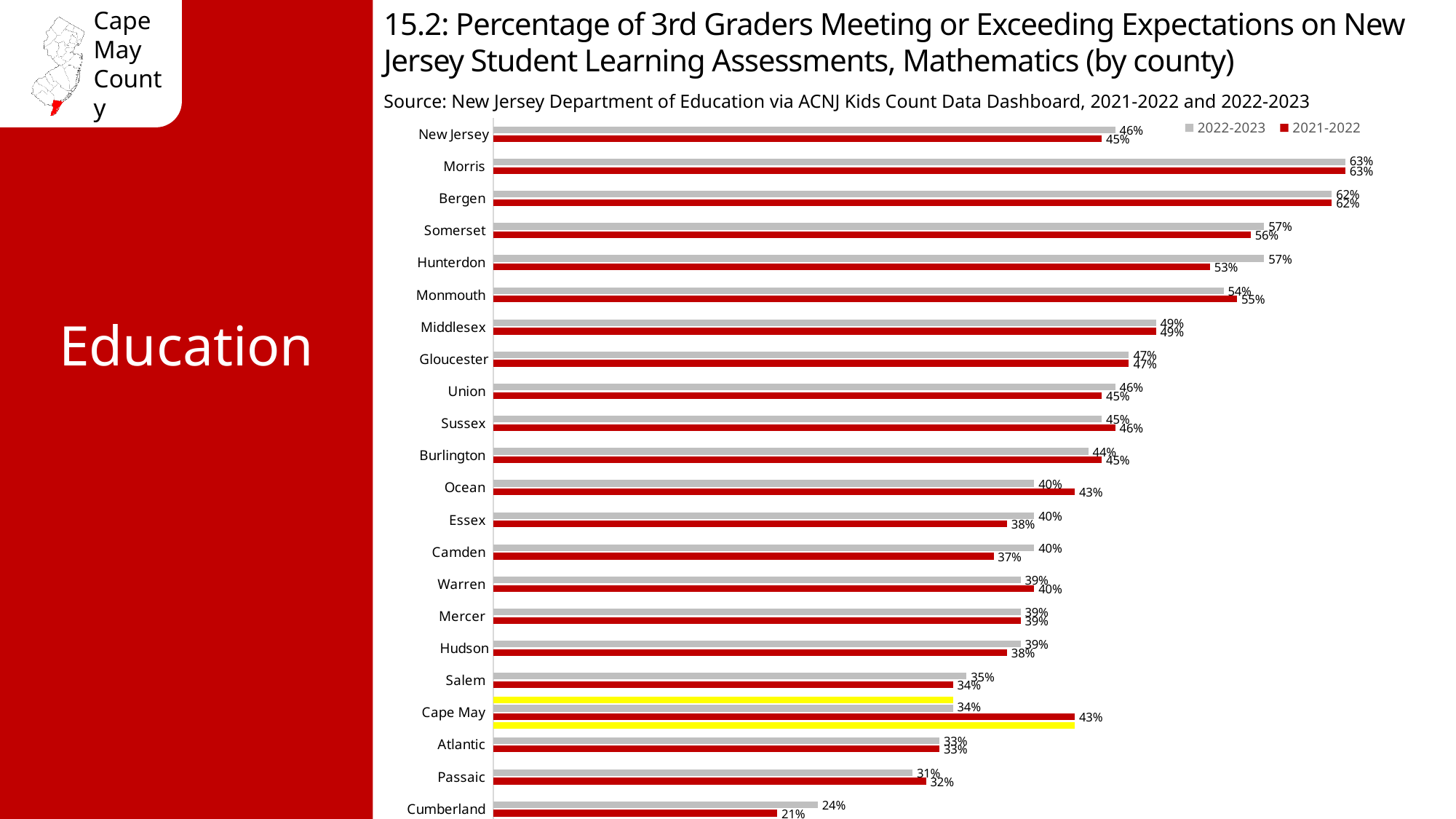
Which is larger for Ocean: the 2022-2023 value or the 2021-2022 value? 2021-2022 What is the 2021-2022 value for Cumberland? 21% Which county has the lowest 2021-2022 value? Cumberland What is the 2021-2022 value for Cape May? 43% What is the 2022-2023 value for Cape May? 34% Which colour represents the 2021-2022 series in the legend? red How many categories (counties plus New Jersey) are shown on the chart? 22 Which county has the highest 2022-2023 value? Morris How many series does the legend list? 2 What is the difference between Cape May's 2021-2022 value and its 2022-2023 value? 9% What is the 2022-2023 value for Hunterdon? 57% What kind of chart is shown on the slide? bar chart